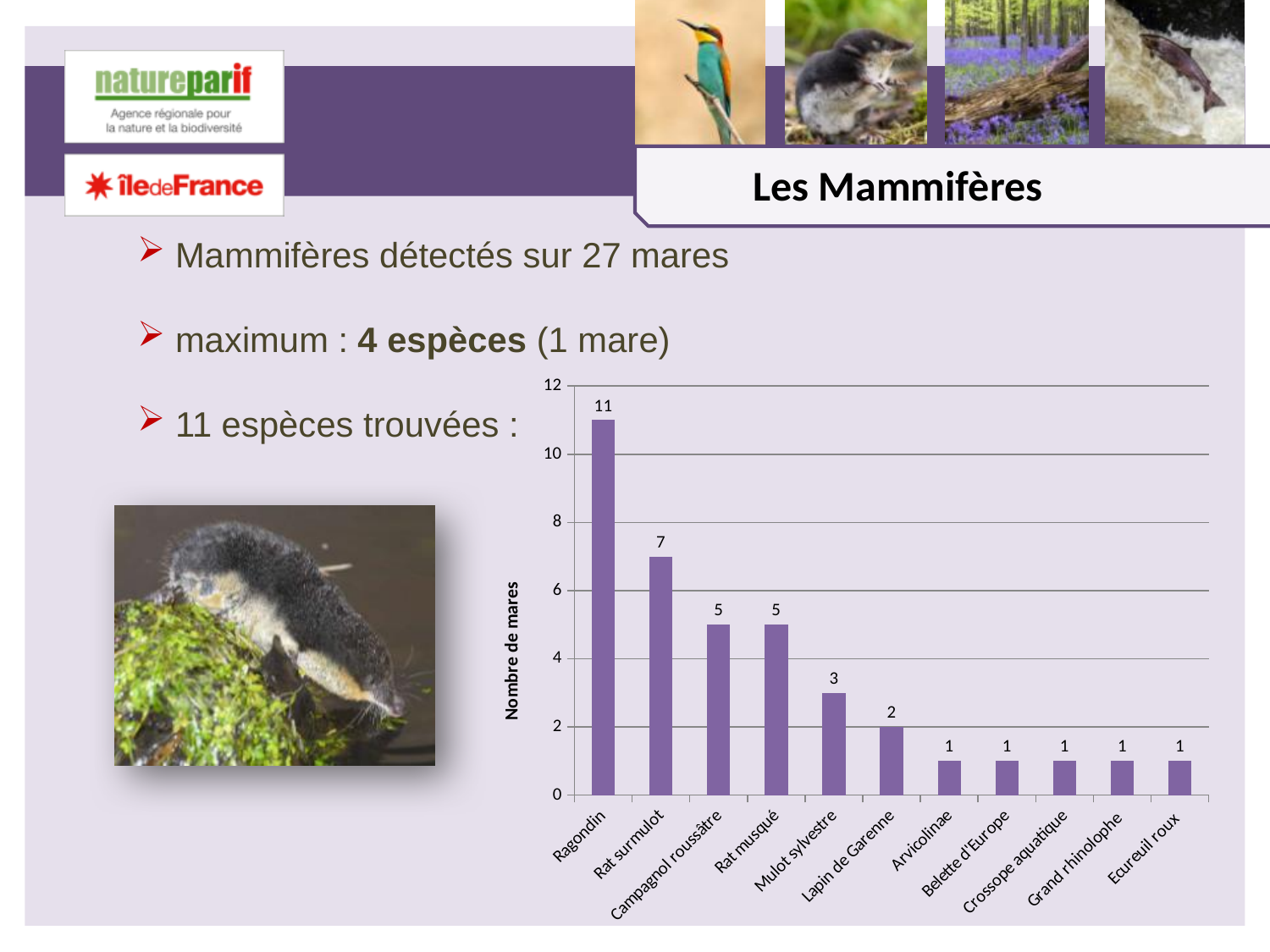
What kind of chart is this? bar chart What is the value for Ragondin? 11 What is the value for Rat surmulot? 7 How many categories are shown on the x axis? 11 What is the difference between the values for Ragondin and Rat surmulot? 4 What is the label of the vertical axis? Nombre de mares What is the value for Lapin de Garenne? 2 Do the values rise or fall from left to right along the x axis? fall Which is larger, the value for Campagnol roussâtre or the value for Mulot sylvestre? Campagnol roussâtre Is the value for Rat surmulot greater or less than 6? greater What is the value for Mulot sylvestre? 3 Which category has the highest value? Ragondin